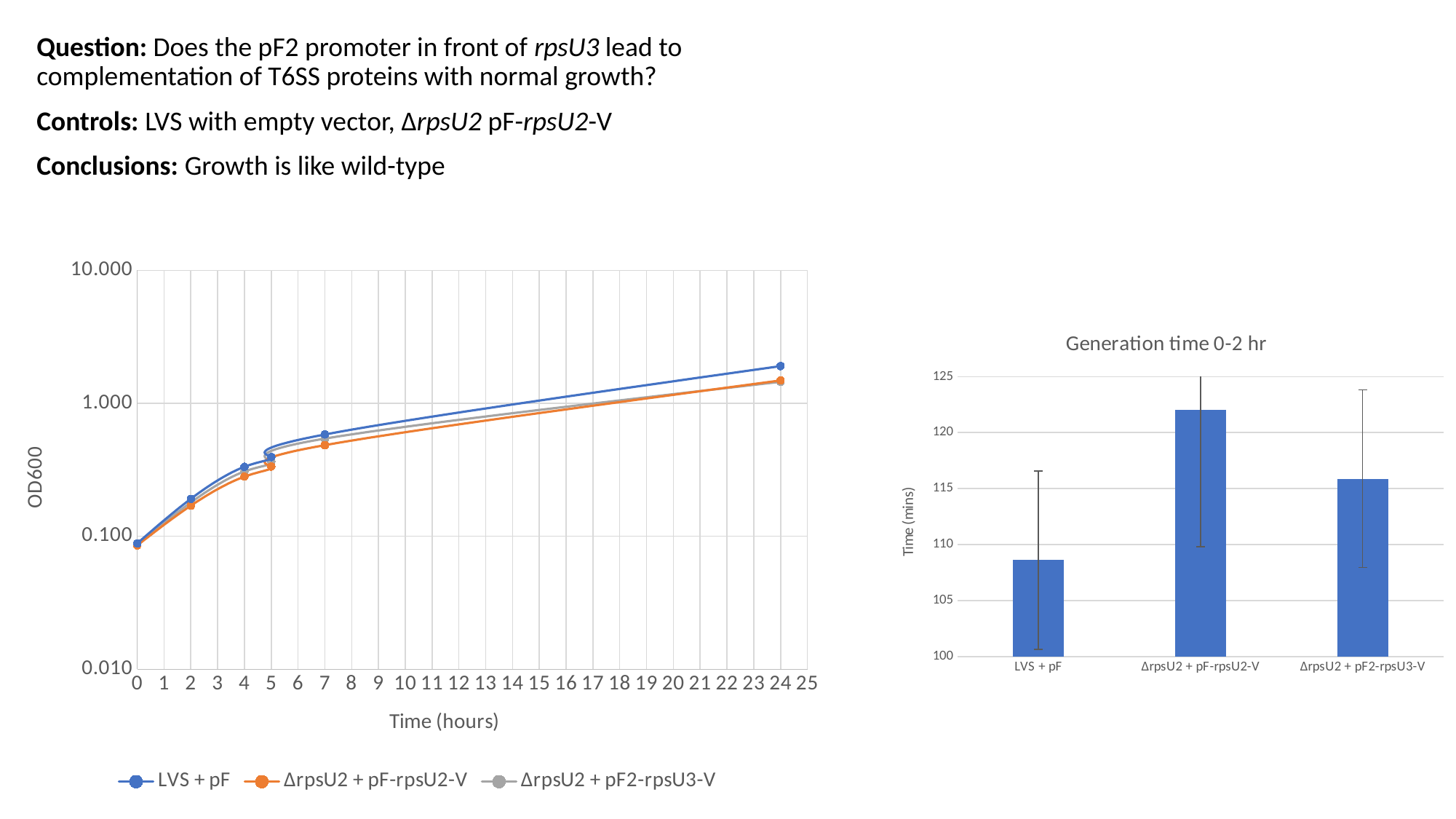
How many series does the legend of the left chart list? 3 What kind of chart is the chart on the left of the slide? line chart In the 'Generation time 0-2 hr' chart, which category has the highest generation time? ΔrpsU2 + pF-rpsU2-V In the 'Generation time 0-2 hr' chart, is the value for LVS + pF greater or less than 110? less How many time points are plotted for each series in the left chart? 6 In the 'Generation time 0-2 hr' chart, how many categories are shown? 3 In the left chart, is the OD600 value for LVS + pF at 24 hours greater or less than 1.000? greater In the 'Generation time 0-2 hr' chart, which category has the lowest generation time? LVS + pF In the left chart, is the OD600 value for LVS + pF at 7 hours greater or less than 1.000? less What is the x-axis label of the left chart? Time (hours) What kind of chart is the 'Generation time 0-2 hr' chart? bar chart In the left chart, do the OD600 values rise or fall as time increases? rise